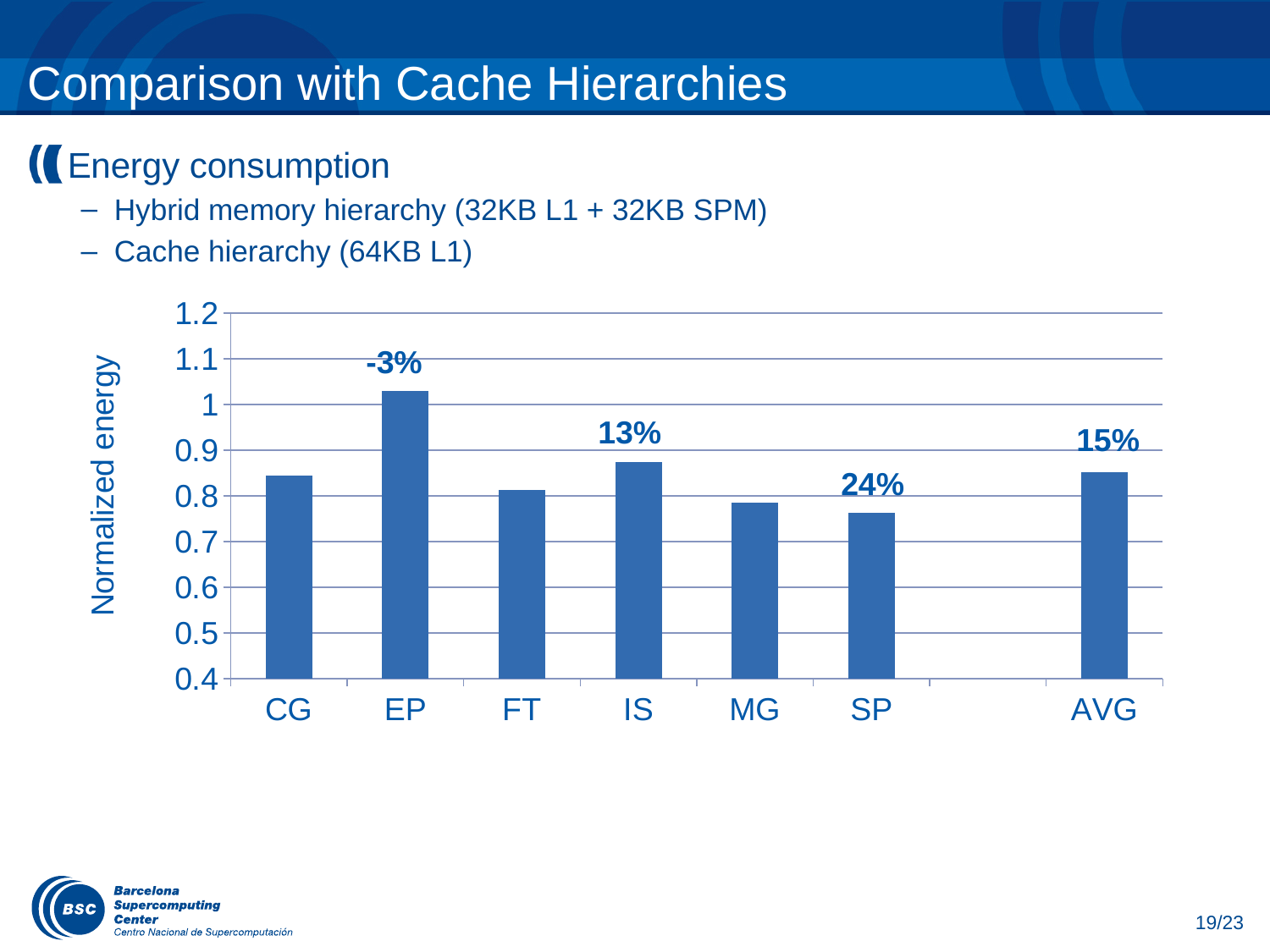
What is the label on the y axis of the chart? Normalized energy Is the normalized energy for EP greater or less than 1? greater Is the normalized energy for AVG greater or less than 0.9? less Is the normalized energy for CG greater or less than 0.9? less Which category has the highest normalized energy? EP Which has a higher normalized energy, IS or FT? IS How many categories are shown on the x axis of the chart? 7 Which category has the lowest normalized energy? SP What kind of chart is shown on the slide? bar chart What percentage annotation is printed above the SP bar? 24% Which has a higher normalized energy, CG or MG? CG